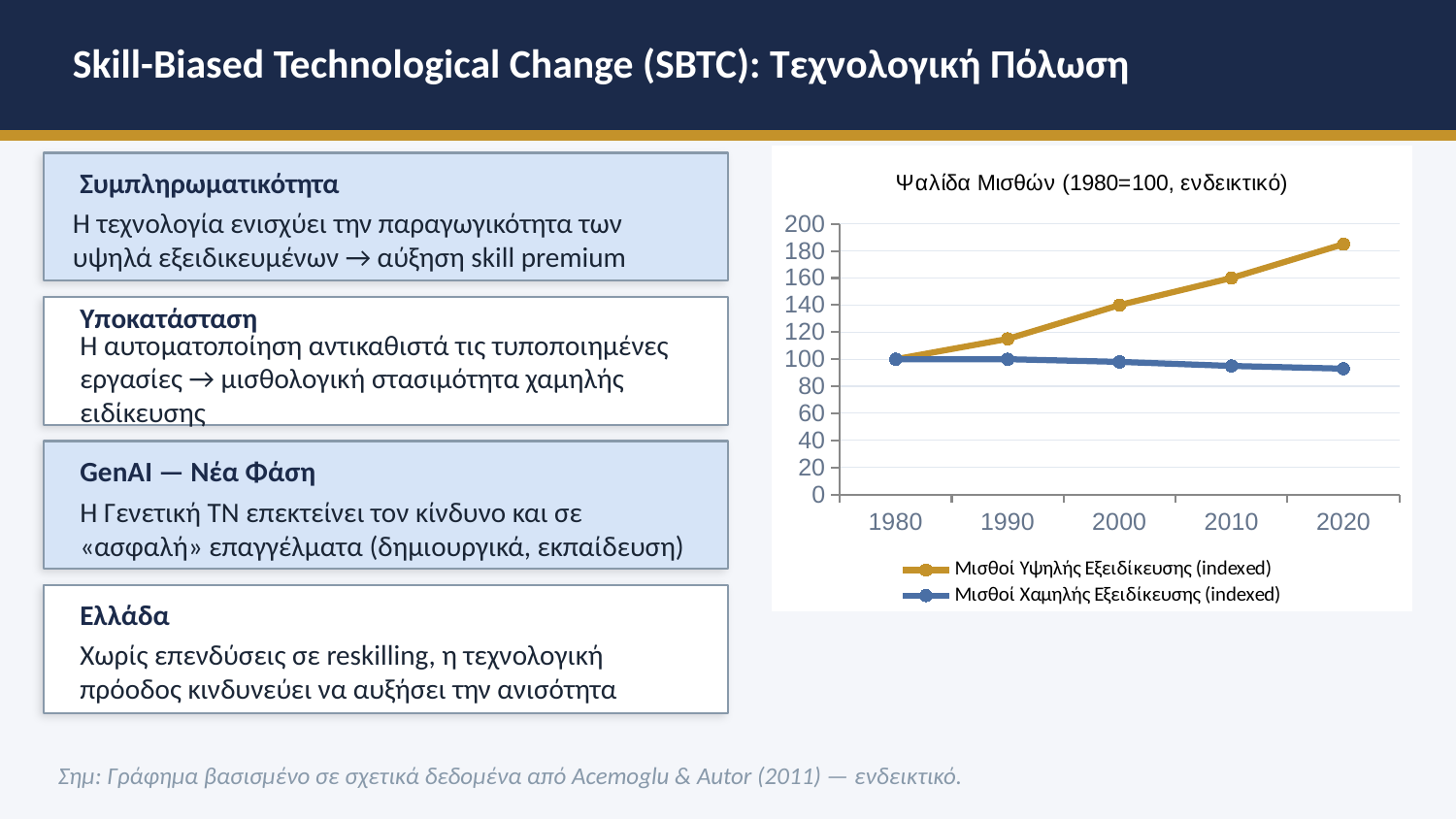
What is the title of the chart? Ψαλίδα Μισθών (1980=100, ενδεικτικό) In 2010, which series has the larger value: Μισθοί Υψηλής Εξειδίκευσης (indexed) or Μισθοί Χαμηλής Εξειδίκευσης (indexed)? Μισθοί Υψηλής Εξειδίκευσης (indexed) What kind of chart is shown on the slide? line chart What is the value of Μισθοί Υψηλής Εξειδίκευσης (indexed) in 1980? 100 What is the value of Μισθοί Χαμηλής Εξειδίκευσης (indexed) in 1980? 100 Is the value for Μισθοί Υψηλής Εξειδίκευσης (indexed) in 2020 greater or less than 160? greater In which year does the Μισθοί Υψηλής Εξειδίκευσης (indexed) series reach its highest value? 2020 How many years are plotted along the x axis of the chart? 5 Does the Μισθοί Χαμηλής Εξειδίκευσης (indexed) series rise or fall from 1980 to 2020? fall Is the value for Μισθοί Χαμηλής Εξειδίκευσης (indexed) in 2020 greater or less than 100? less Does the Μισθοί Υψηλής Εξειδίκευσης (indexed) series rise or fall from 1980 to 2020? rise How many series does the chart legend list? 2